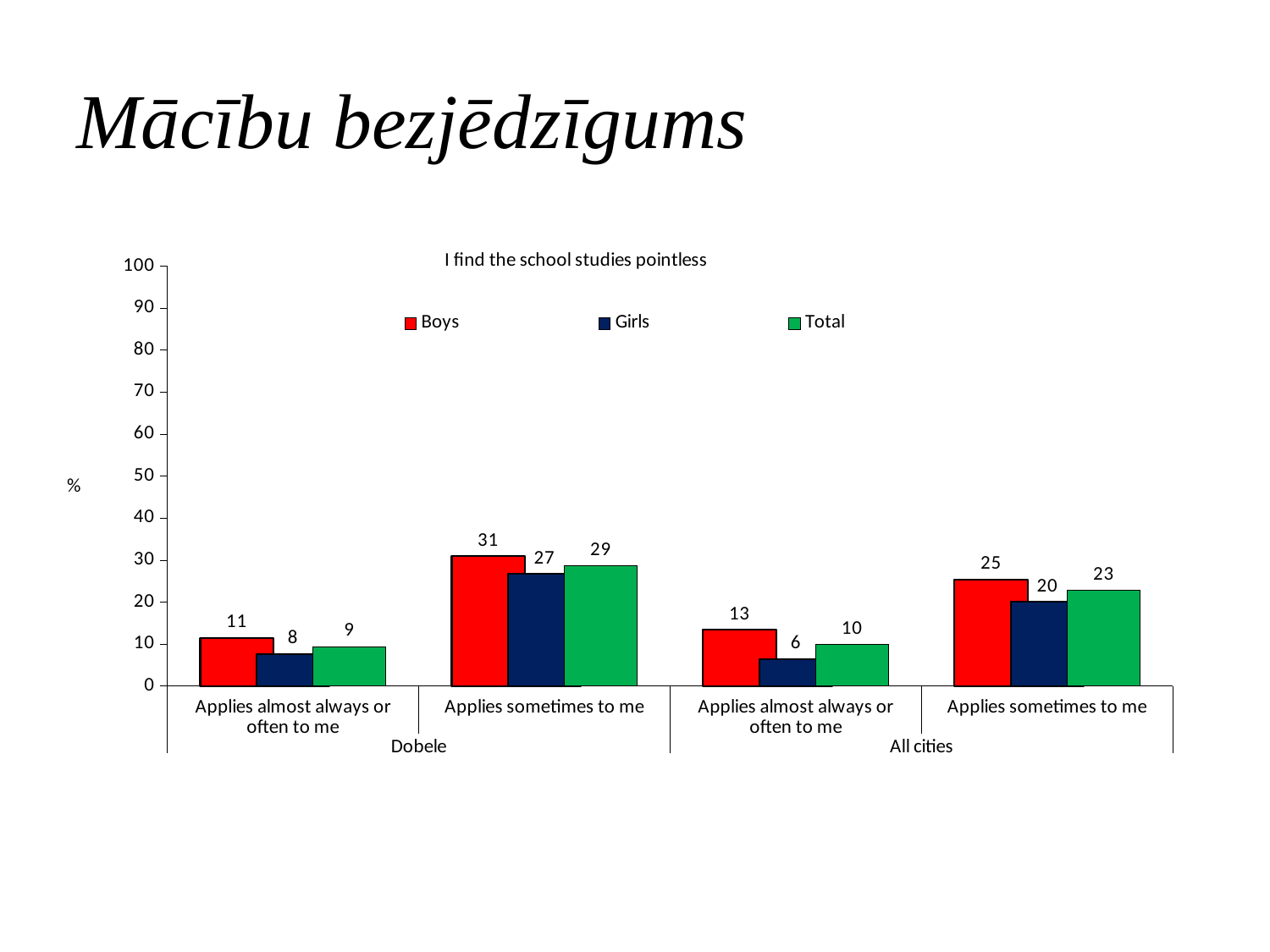
Is the Boys value for 'Applies sometimes to me' in Dobele larger or smaller than the Boys value for 'Applies sometimes to me' in All cities? larger What is the value for Boys in the 'Applies sometimes to me' category for Dobele? 31 What kind of chart is shown on the slide? bar chart How many series does the legend list? 3 Is the Total value for 'Applies almost always or often to me' in Dobele greater or less than 20? less What colour represents the Girls series? dark blue Which series has the highest value in the 'Applies sometimes to me' category for Dobele? Boys What is the title of the chart? I find the school studies pointless What is the value for Girls in the 'Applies almost always or often to me' category for All cities? 6 What is the Total value for 'Applies sometimes to me' in All cities? 23 Which series has the lowest value in the 'Applies almost always or often to me' category for All cities? Girls What is the difference between the Boys and Girls values for 'Applies sometimes to me' in All cities? 5